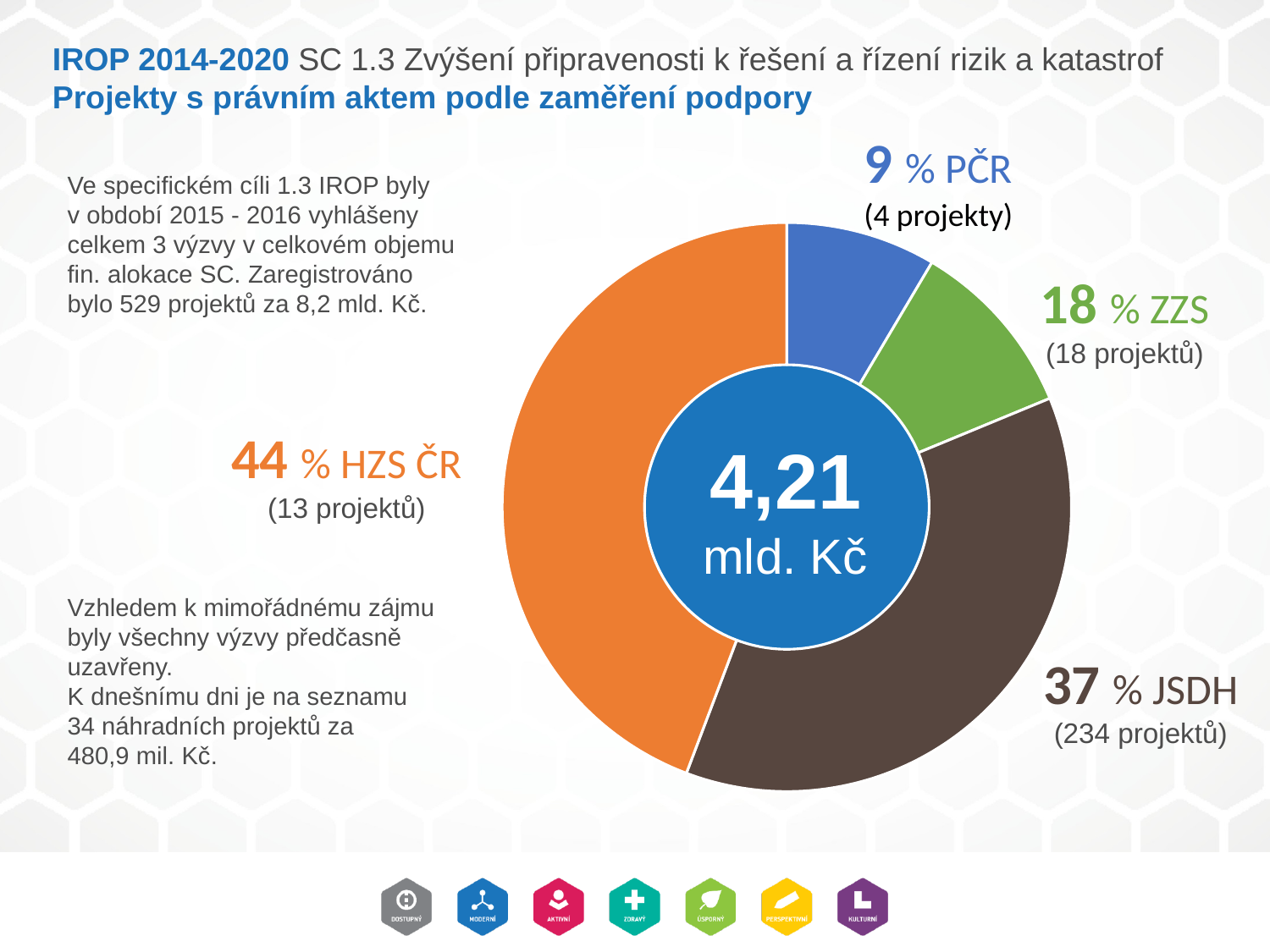
What share of the pie does PČR have? 9 % How many slices does the pie chart have? 4 Which category has the smallest share of the pie? PČR What value is printed in the centre of the pie chart? 4,21 mld. Kč What kind of chart is shown on the slide? doughnut chart Which category has the largest share of the pie? HZS ČR How many projects are listed for JSDH? 234 projektů What share of the pie does JSDH have? 37 % What share of the pie does ZZS have? 18 % What is the difference in percentage points between the HZS ČR share and the JSDH share? 7 How many projects are listed for HZS ČR? 13 projektů